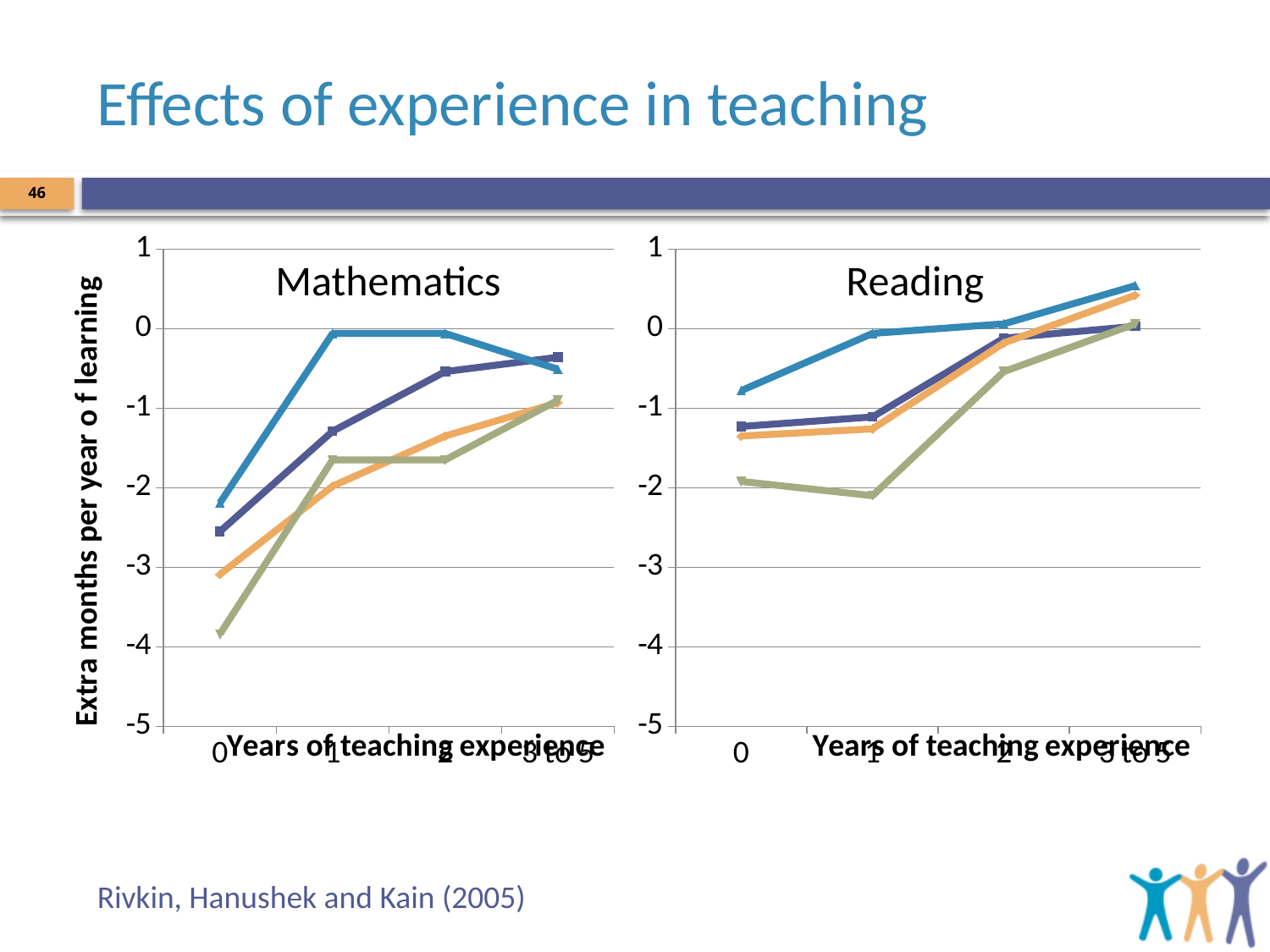
What kind of chart is the Mathematics chart? line chart In the Reading chart, is the value of the light blue line at 0 years of experience greater or less than -1? greater In the Mathematics chart, is the value of the light blue line at 0 years of experience greater or less than -2? less What is the x-axis title of the Reading chart? Years of teaching experience In the Mathematics chart, is the value of the green line at 0 years of experience greater or less than -3? less In the Mathematics chart, which line has the lowest value at 0 years of experience, the green line or the light blue line? the green line In the Reading chart, do the values generally rise or fall from 0 years to 3 to 5 years of experience? rise In the Mathematics chart, do the values generally rise or fall as years of teaching experience increase? rise What is the title of the y axis shared by the two charts? Extra months per year of learning How many categories are shown on the x axis of the Reading chart? 4 How many lines are plotted in the Mathematics chart? 4